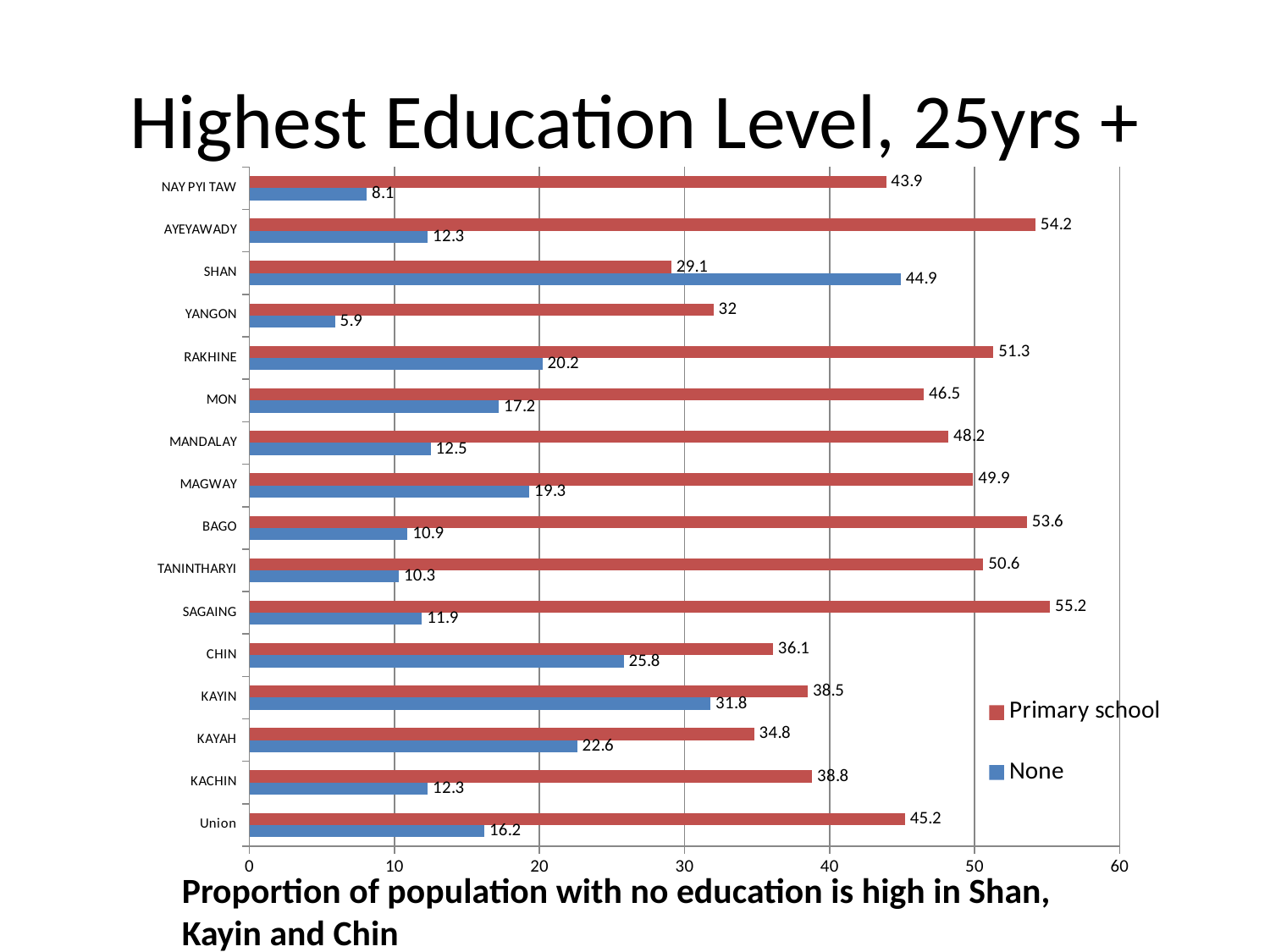
Which category has the highest Primary school value? SAGAING What is the difference between the Primary school and None values for KAYIN? 6.7 Is the Primary school value for RAKHINE greater or less than 50? greater What is the Primary school value for SAGAING? 55.2 Which category has the highest None value? SHAN How many series does the legend list? 2 What is the None value for SHAN? 44.9 What kind of chart is shown on the slide? Bar chart What is the None value for Union? 16.2 How many categories are shown on the chart? 16 Which is larger for SHAN, the Primary school value or the None value? None Which category has the lowest None value? YANGON